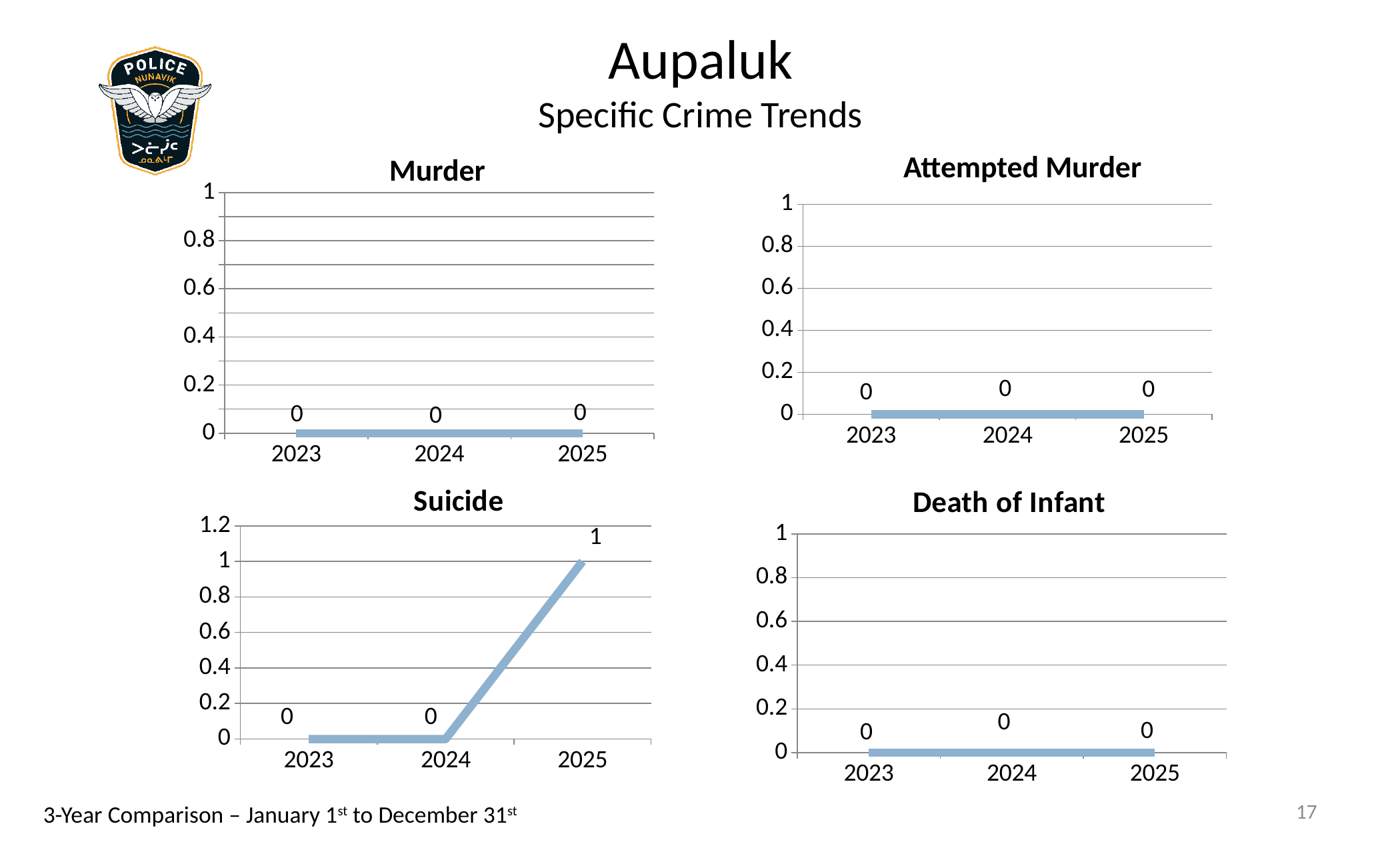
How many years are plotted in the Murder chart? 3 In the Death of Infant chart, what is the value for 2023? 0 In the Suicide chart, which is larger, the value for 2025 or the value for 2023? 2025 In the Murder chart, what is the value for 2024? 0 In the Suicide chart, which year has the highest value? 2025 In the Suicide chart, what is the difference between the values for 2025 and 2024? 1 What kind of chart is the Suicide chart? line chart In the Suicide chart, what is the value for 2023? 0 In the Suicide chart, do the values rise or fall from 2024 to 2025? rise In the Attempted Murder chart, what is the value for 2025? 0 What is the title of the chart in the bottom right of the slide? Death of Infant In the Suicide chart, what is the value for 2025? 1